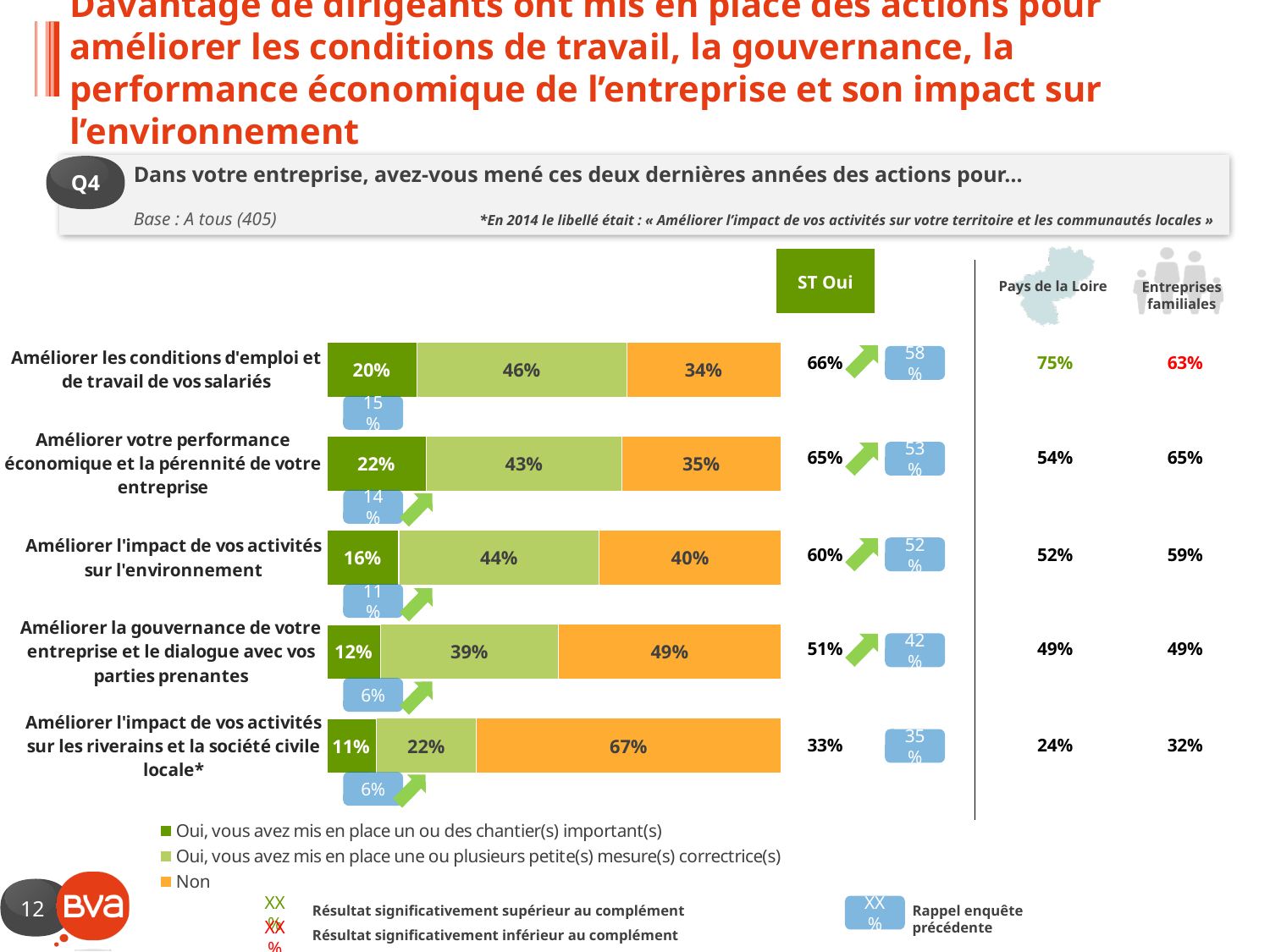
Which category has the lowest value for "Oui, vous avez mis en place un ou des chantier(s) important(s)"? Améliorer l'impact de vos activités sur les riverains et la société civile locale* What colour represents the "Non" series in the chart? Orange What is the value of "Oui, vous avez mis en place un ou des chantier(s) important(s)" for "Améliorer votre performance économique et la pérennité de votre entreprise"? 22% What type of chart is shown on the slide? Stacked bar chart What is the difference between the "Non" values for "Améliorer la gouvernance de votre entreprise et le dialogue avec vos parties prenantes" and "Améliorer les conditions d'emploi et de travail de vos salariés"? 15% How many categories (actions) are plotted in the chart? 5 Which category has the highest value for "Non"? Améliorer l'impact de vos activités sur les riverains et la société civile locale* What is the value of "Non" for "Améliorer l'impact de vos activités sur les riverains et la société civile locale*"? 67% What is the value of "Oui, vous avez mis en place une ou plusieurs petite(s) mesure(s) correctrice(s)" for "Améliorer l'impact de vos activités sur l'environnement"? 44% What is the combined total of the two "Oui" series for "Améliorer l'impact de vos activités sur l'environnement"? 60% Which is larger: the "Oui, vous avez mis en place une ou plusieurs petite(s) mesure(s) correctrice(s)" value for "Améliorer les conditions d'emploi et de travail de vos salariés" or for "Améliorer la gouvernance de votre entreprise et le dialogue avec vos parties prenantes"? Améliorer les conditions d'emploi et de travail de vos salariés How many series does the legend list? 3